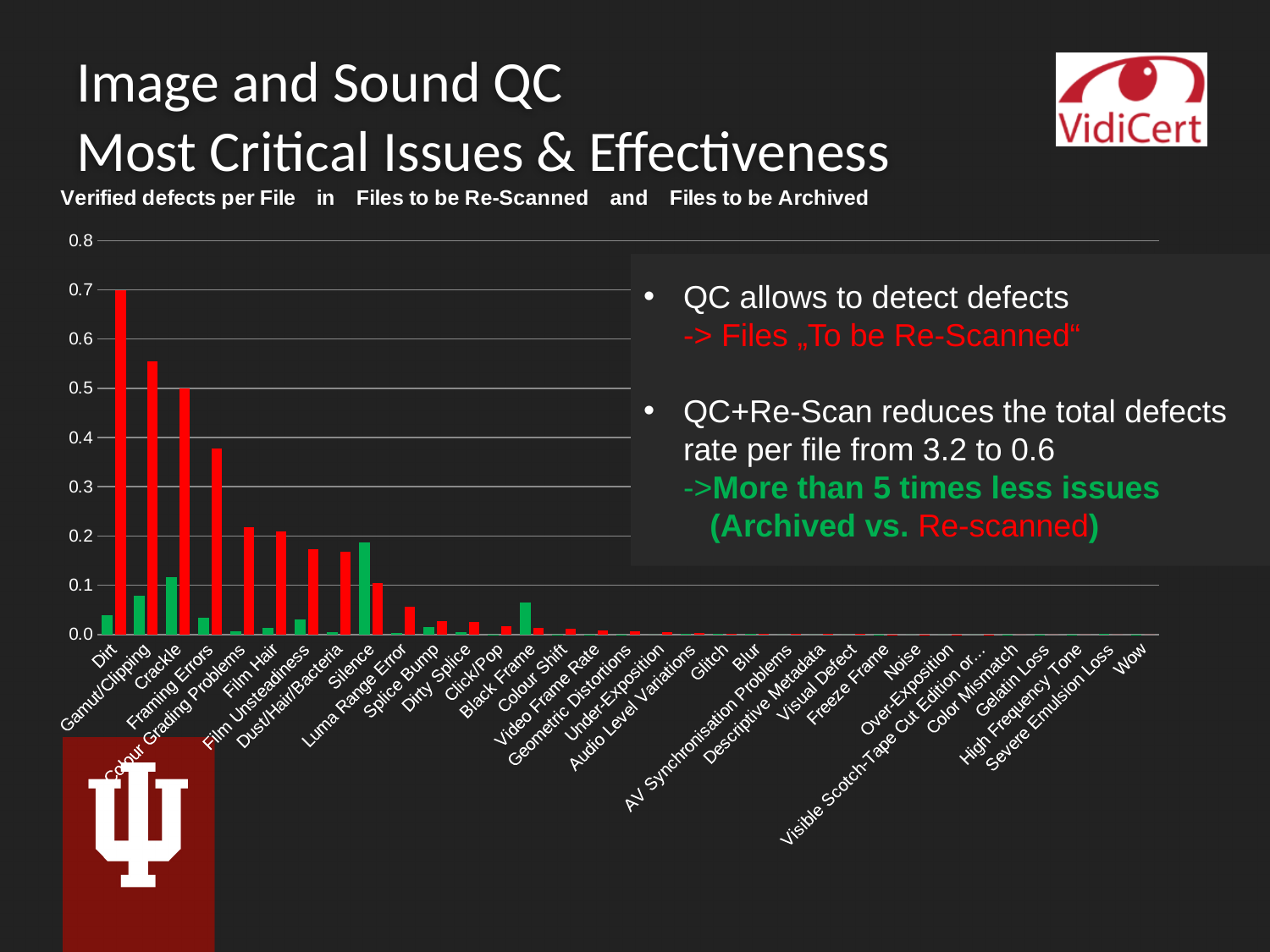
Which category has the tallest red bar? Dirt Is the red bar value for Crackle greater or less than 0.4? greater Which has the taller red bar, Dirt or Gamut/Clipping? Dirt Is the red bar value for Gamut/Clipping greater or less than 0.5? greater How many categories are shown on the x axis of the chart? 33 What is the label of the last category on the right of the x axis? Wow Do the red bars generally rise or fall from left to right along the x axis? fall For Silence, which bar is taller, the red one or the green one? the green one Is the red bar value for Framing Errors greater or less than 0.3? greater What kind of chart is shown on the slide? bar chart